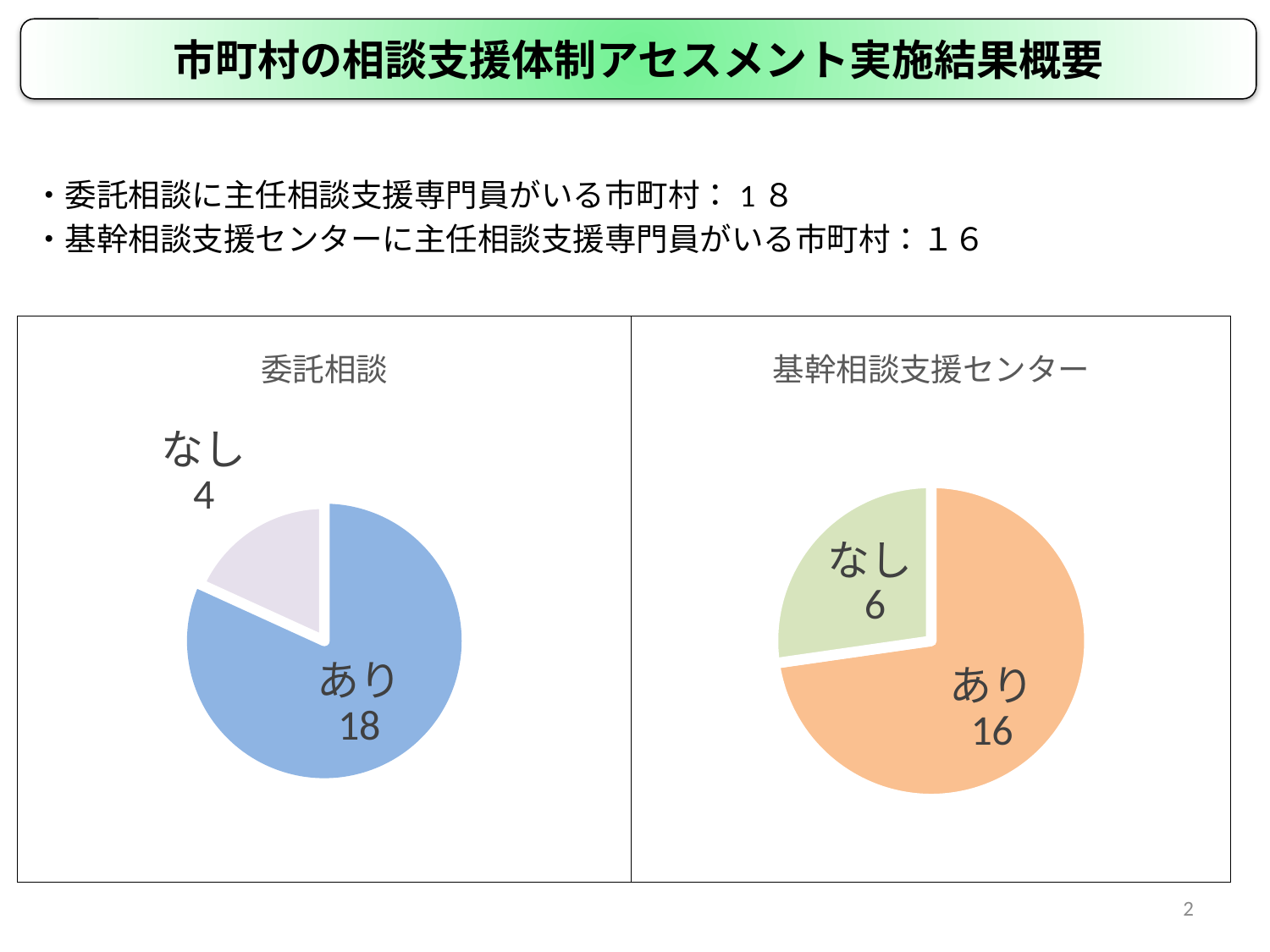
In the 委託相談 pie chart, which slice is the largest? あり What kind of chart is the 基幹相談支援センター chart? pie chart In the 基幹相談支援センター pie chart, what is the difference between あり and なし? 10 Which is larger: なし in the 委託相談 chart or なし in the 基幹相談支援センター chart? なし in the 基幹相談支援センター chart In the 委託相談 pie chart, what is the value for なし? 4 In the 基幹相談支援センター pie chart, what is the value for あり? 16 How many slices does the 委託相談 pie chart have? 2 What is the title of the chart on the left side of the slide? 委託相談 In the 委託相談 pie chart, what is the difference between あり and なし? 14 In the 基幹相談支援センター pie chart, which slice is the smallest? なし In the 基幹相談支援センター pie chart, what is the value for なし? 6 In the 委託相談 pie chart, what is the value for あり? 18